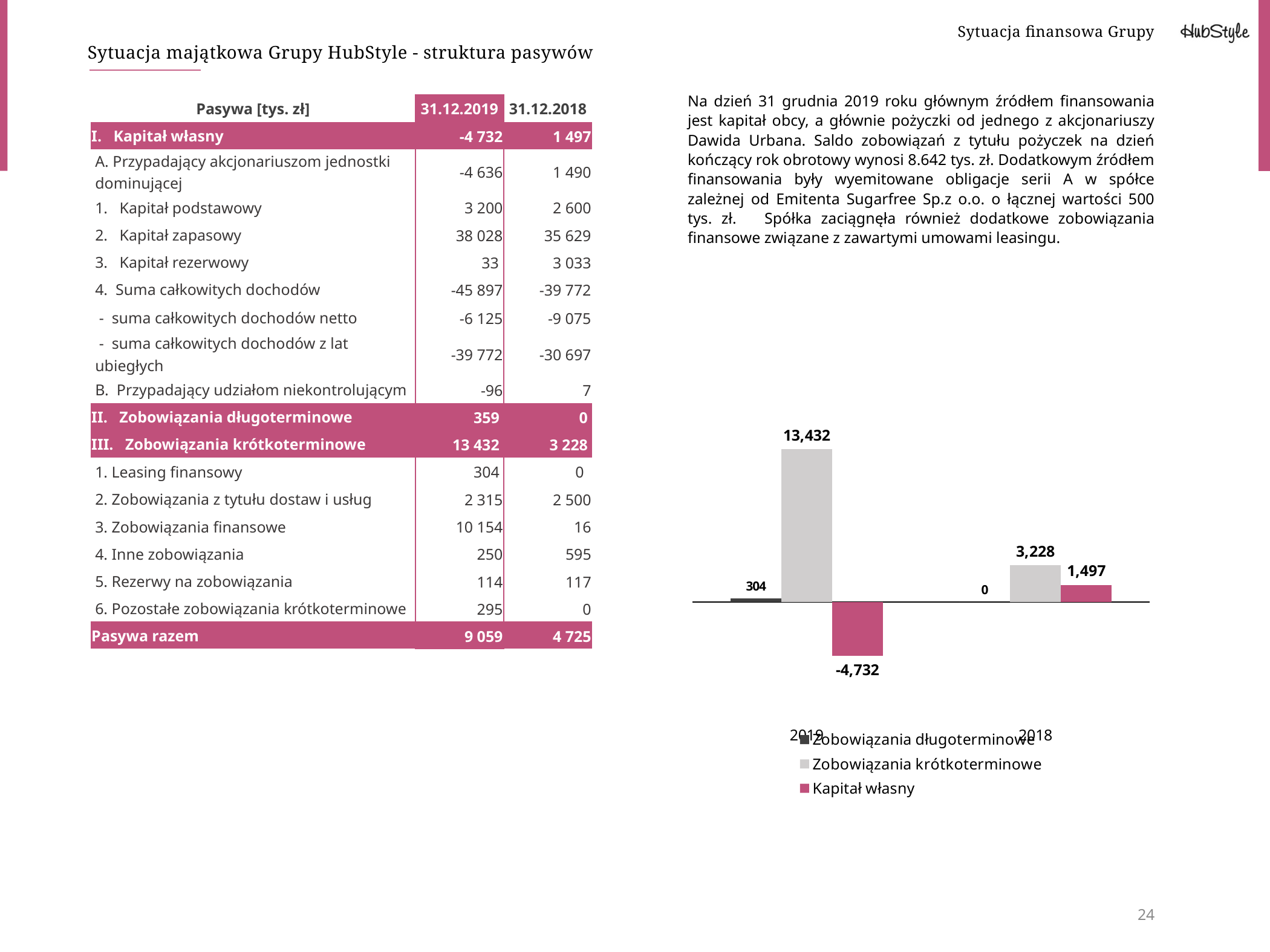
What is the value of Kapitał własny for 2019 in the chart? -4,732 What is the value of Zobowiązania krótkoterminowe for 2018 in the chart? 3,228 Which year has the higher value for Zobowiązania krótkoterminowe in the chart? 2019 Which series has the lowest value in the chart? Kapitał własny What is the value of Zobowiązania długoterminowe for 2018 in the chart? 0 What is the difference between Zobowiązania krótkoterminowe in 2019 and 2018 in the chart? 10,204 What is the value of Kapitał własny for 2018 in the chart? 1,497 How many series does the chart legend list? 3 How many year categories are shown on the chart's x axis? 2 What type of chart is shown on the slide? bar chart Which series is shown in pink in the chart? Kapitał własny What is the value of Zobowiązania krótkoterminowe for 2019 in the chart? 13,432